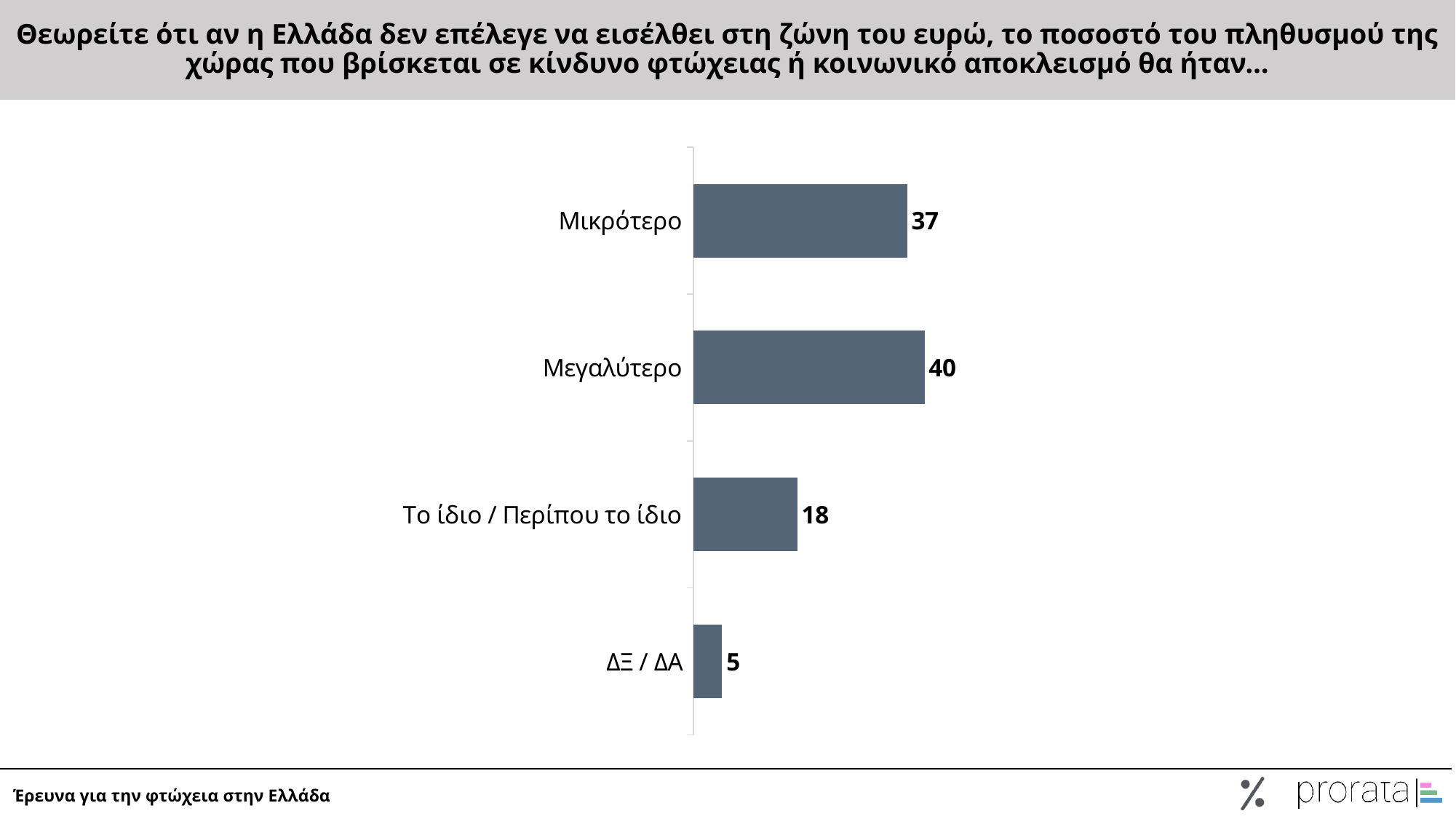
What is the value for Μεγαλύτερο? 40 Which is larger, the value for Το ίδιο / Περίπου το ίδιο or the value for ΔΞ / ΔΑ? Το ίδιο / Περίπου το ίδιο What is the footer text at the bottom left of the slide? Έρευνα για την φτώχεια στην Ελλάδα What is the value for ΔΞ / ΔΑ? 5 Which category has the highest value? Μεγαλύτερο What is the difference between the values for Μεγαλύτερο and Μικρότερο? 3 What is the value for Μικρότερο? 37 Which category has the lowest value? ΔΞ / ΔΑ What kind of chart is shown on the slide? Bar chart What is the difference between the values for Μικρότερο and Το ίδιο / Περίπου το ίδιο? 19 How many categories are shown in the chart? 4 What is the value for Το ίδιο / Περίπου το ίδιο? 18